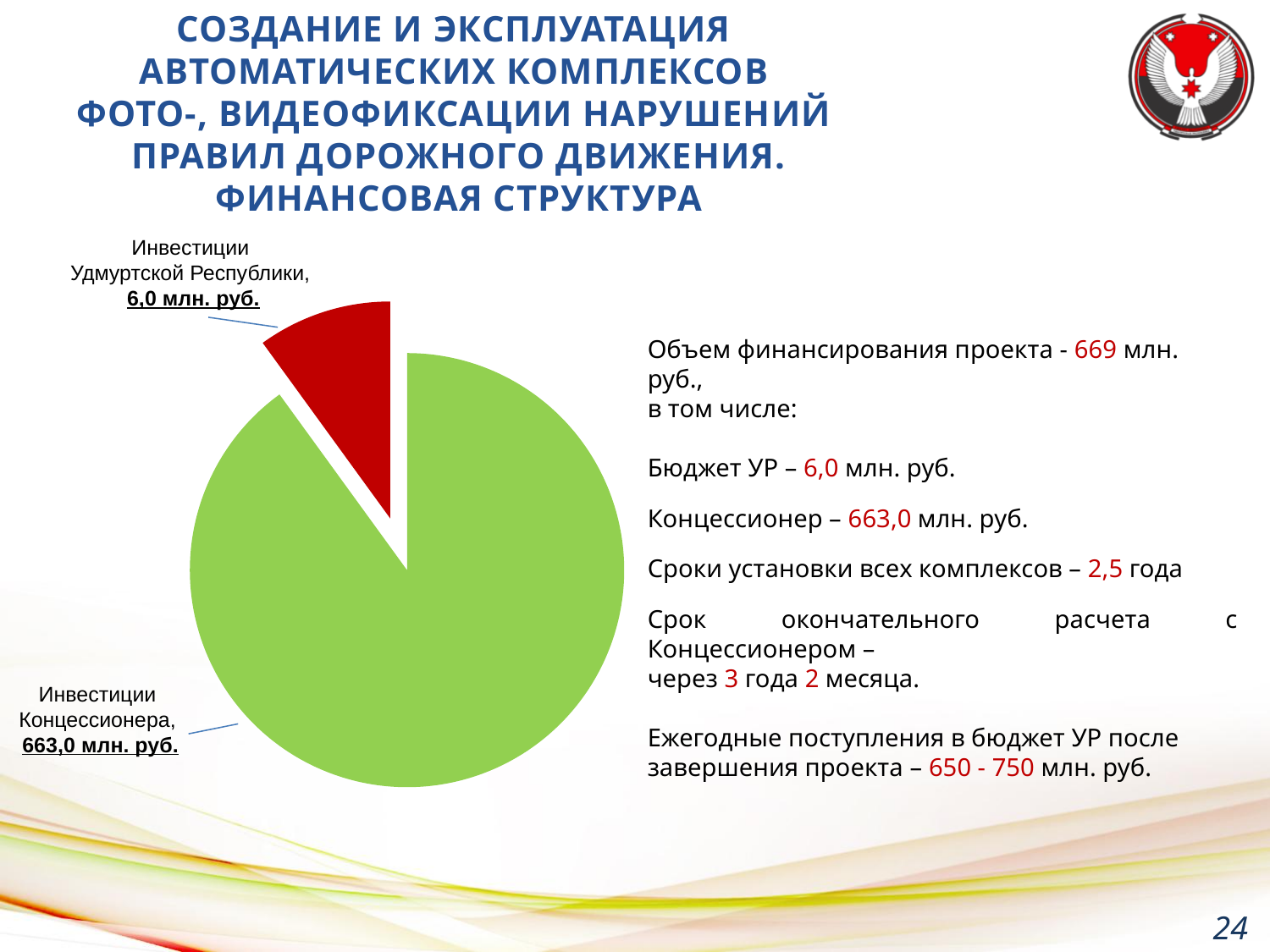
What colour is the slice for Инвестиции Удмуртской Республики? Red What is the total of the two slices in the pie chart? 669 млн. руб. What colour is the slice for Инвестиции Концессионера? Green Which slice of the pie chart is the smallest? Инвестиции Удмуртской Республики What is the difference between Инвестиции Концессионера and Инвестиции Удмуртской Республики? 657,0 млн. руб. What kind of chart is shown on the slide? Pie chart Which slice of the pie chart is the largest? Инвестиции Концессионера What is the value of the slice labelled "Инвестиции Концессионера"? 663,0 млн. руб. How many slices does the pie chart have? 2 What is the value of the slice labelled "Инвестиции Удмуртской Республики"? 6,0 млн. руб. Which is larger: Инвестиции Концессионера or Инвестиции Удмуртской Республики? Инвестиции Концессионера